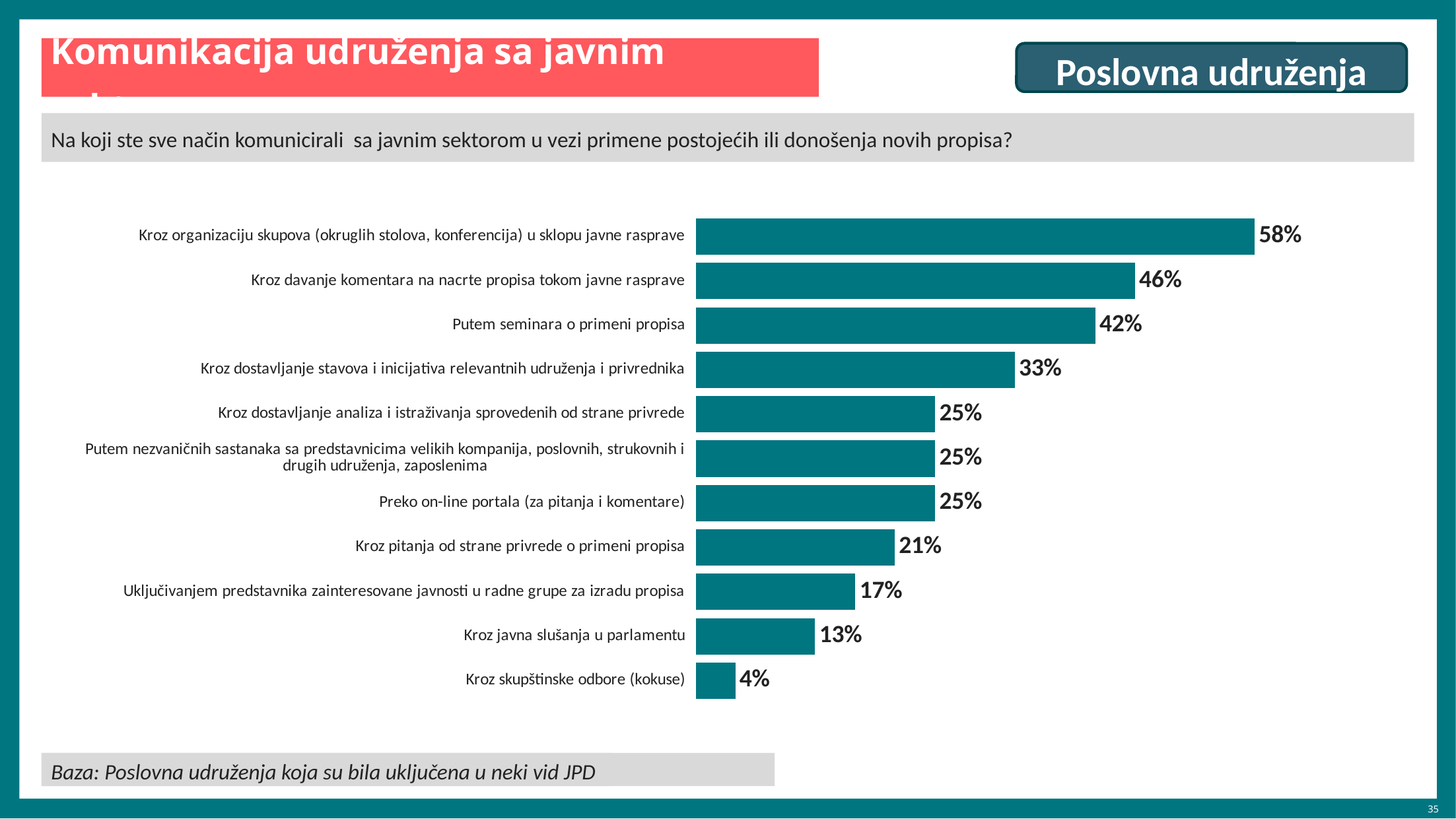
How many categories are shown in the chart? 11 How many categories have a value of 25%? 3 What is the value for "Kroz pitanja od strane privrede o primeni propisa"? 21% What is the value for "Kroz organizaciju skupova (okruglih stolova, konferencija) u sklopu javne rasprave"? 58% What is the value for "Kroz javna slušanja u parlamentu"? 13% Which category has the lowest value? Kroz skupštinske odbore (kokuse) Which is larger: the value for "Uključivanjem predstavnika zainteresovane javnosti u radne grupe za izradu propisa" or the value for "Kroz javna slušanja u parlamentu"? Uključivanjem predstavnika zainteresovane javnosti u radne grupe za izradu propisa What is the difference between the values for "Kroz davanje komentara na nacrte propisa tokom javne rasprave" and "Kroz dostavljanje stavova i inicijativa relevantnih udruženja i privrednika"? 13% Which category has the highest value? Kroz organizaciju skupova (okruglih stolova, konferencija) u sklopu javne rasprave What kind of chart is shown on the slide? Bar chart What is the difference between the highest and lowest values in the chart? 54% What is the value for "Putem seminara o primeni propisa"? 42%